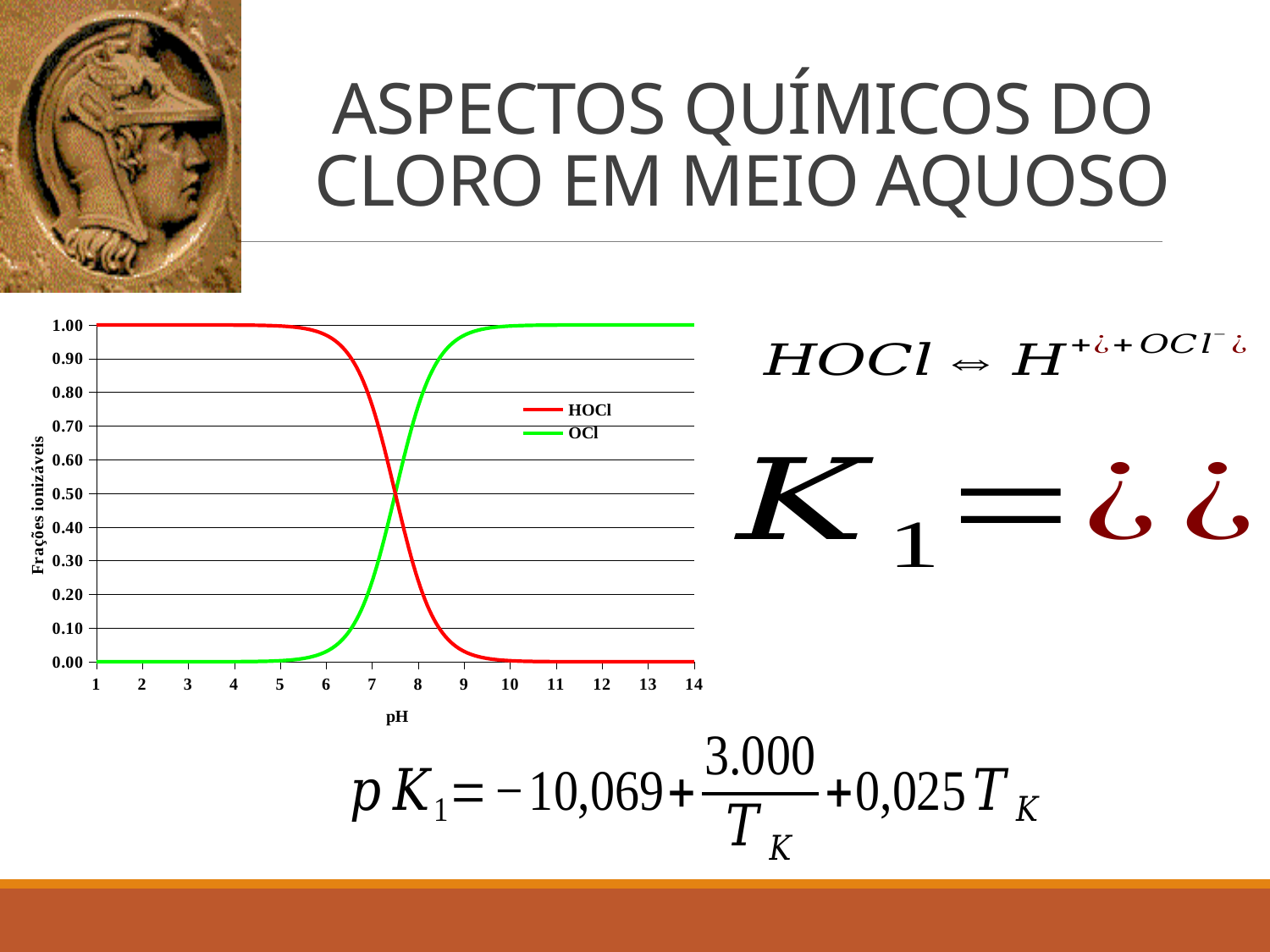
Is the HOCl value at pH 10 greater or less than 0.10? less Which two series are listed in the chart legend? HOCl and OCl At pH 6, which series has the larger value, HOCl or OCl? HOCl Does the HOCl curve rise or fall as pH increases along the x axis? fall How many series does the chart legend list? 2 Does the OCl curve rise or fall as pH increases along the x axis? rise At pH 9, which series has the larger value, HOCl or OCl? OCl What kind of chart is shown on the slide? line chart Is the HOCl value at pH 5 greater or less than 0.90? greater What is the label of the x axis of the chart? pH Is the OCl value at pH 10 greater or less than 0.90? greater